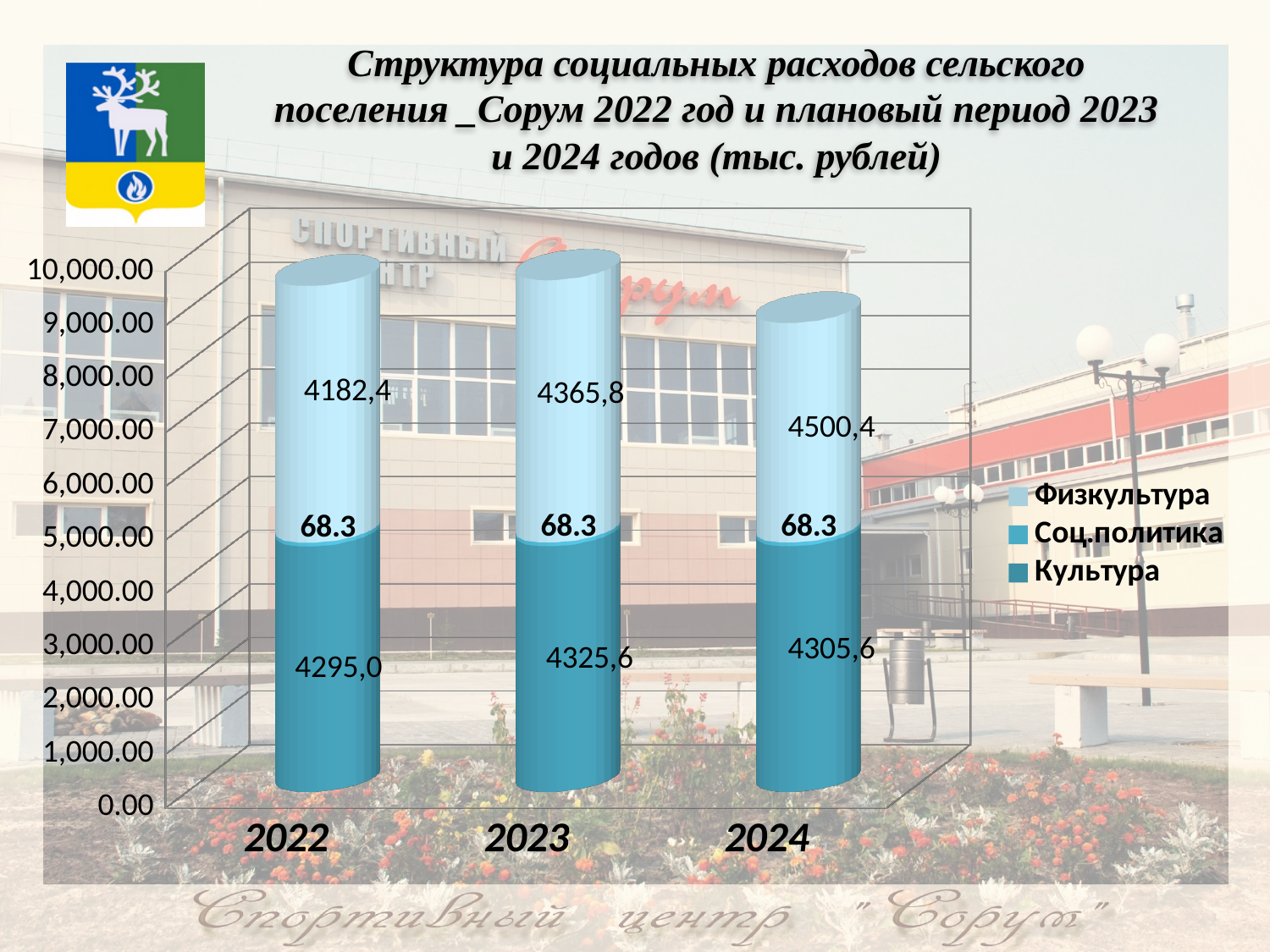
What is the value for Соц.политика in 2024? 68.3 What is the value for Физкультура in 2022? 4182,4 What kind of chart is shown on the slide? Stacked bar chart In 2023, which is larger: Физкультура or Культура? Физкультура In which year is the value for Культура the lowest? 2022 What is the value for Физкультура in 2024? 4500,4 How many years are shown on the x axis? 3 By how much does the value for Физкультура in 2024 exceed the value for Физкультура in 2022? 318,0 How many series does the legend list? 3 What is the value for Культура in 2023? 4325,6